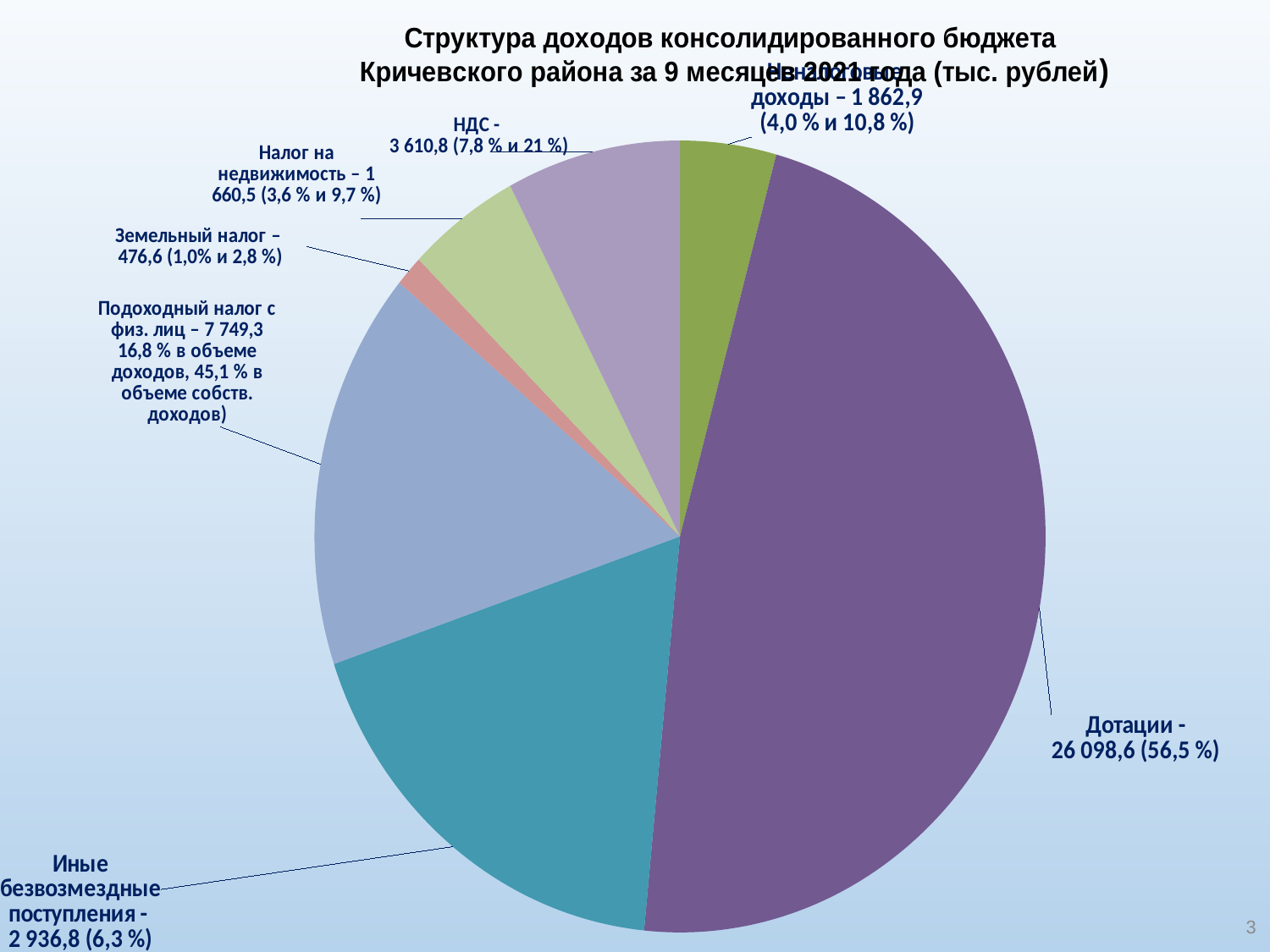
What kind of chart is shown on the slide? pie chart How many slices does the pie chart have? 7 What is the value for Налог на недвижимость? 1 660,5 What share of the pie does Иные безвозмездные поступления take? 6,3 % What is the difference between Дотации and Подоходный налог с физ. лиц? 18 349,3 What share of the pie does Дотации take? 56,5 % What is the value for Дотации? 26 098,6 What is the value for Подоходный налог с физ. лиц? 7 749,3 Which is larger, НДС or Иные безвозмездные поступления? НДС What is the value for НДС? 3 610,8 Which slice is the largest? Дотации Which slice is the smallest? Земельный налог